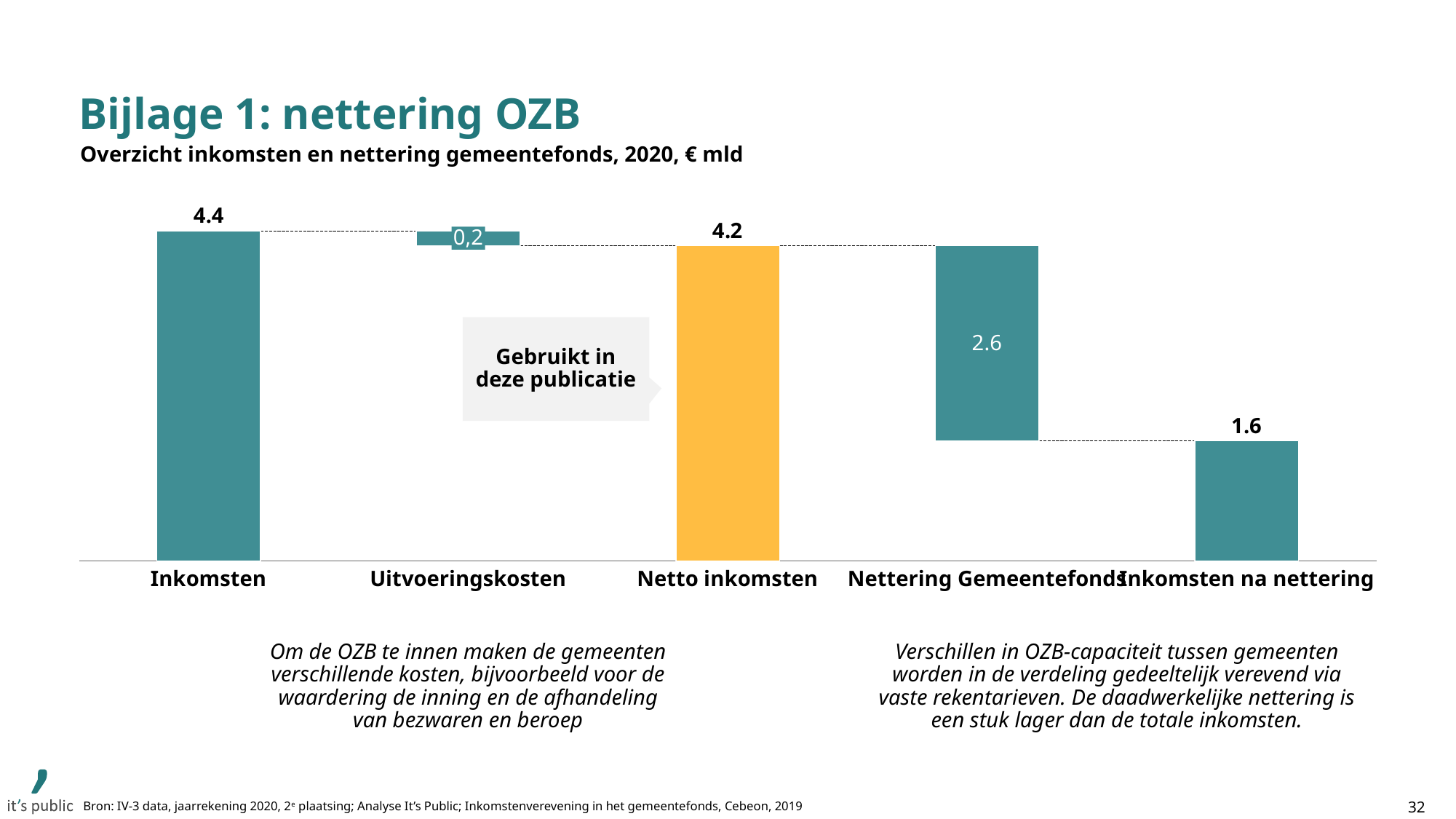
What is the difference between Inkomsten and Inkomsten na nettering? 2.8 Which bar is highlighted in orange/yellow? Netto inkomsten What kind of chart is shown on the slide? Waterfall bar chart What is the value for Netto inkomsten? 4.2 Which category has the highest value? Inkomsten What is the value for Inkomsten? 4.4 What is the value for Nettering Gemeentefonds? 2.6 What is the value for Inkomsten na nettering? 1.6 Which category has the lowest value? Uitvoeringskosten What is the value shown for Uitvoeringskosten? 0,2 Which is larger, Nettering Gemeentefonds or Inkomsten na nettering? Nettering Gemeentefonds How many categories are shown on the x axis? 5